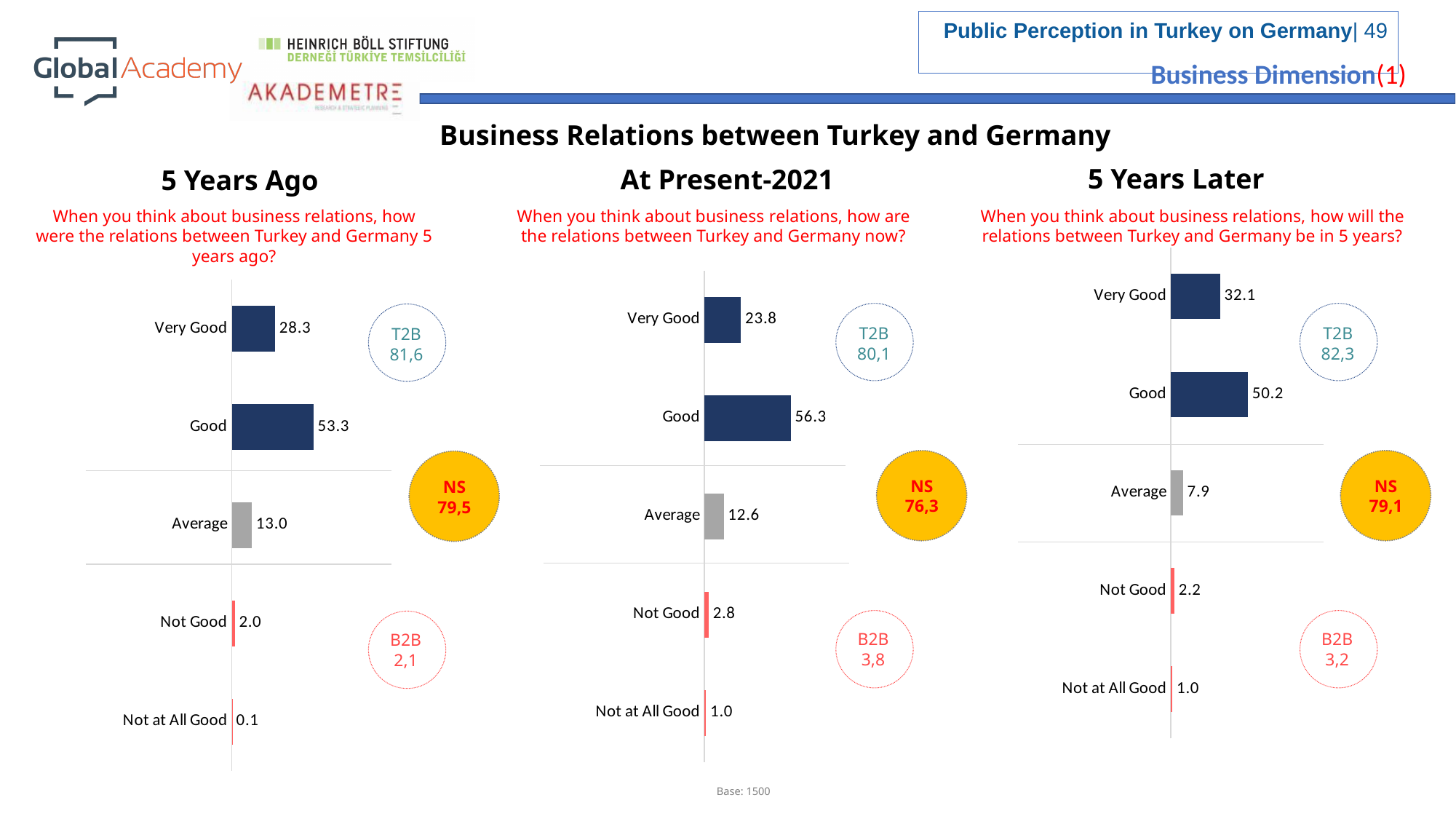
Which is larger: the value for Very Good in the '5 Years Ago' chart or the value for Very Good in the '5 Years Later' chart? 5 Years Later In the 'At Present-2021' chart, what is the value for Very Good? 23.8 In the '5 Years Ago' chart, which category has the lowest value? Not at All Good In the 'At Present-2021' chart, what is the difference between the values for Good and Very Good? 32.5 What is the NS value shown next to the '5 Years Later' chart? 79,1 In the '5 Years Later' chart, what is the value for Average? 7.9 In the '5 Years Ago' chart, what is the value for Good? 53.3 What is the T2B value shown next to the 'At Present-2021' chart? 80,1 How many categories are shown in the 'At Present-2021' chart? 5 What type of chart is used in the '5 Years Ago' chart? Bar chart In the '5 Years Later' chart, which category has the highest value? Good In the '5 Years Ago' chart, what is the difference between the values for Not Good and Not at All Good? 1.9